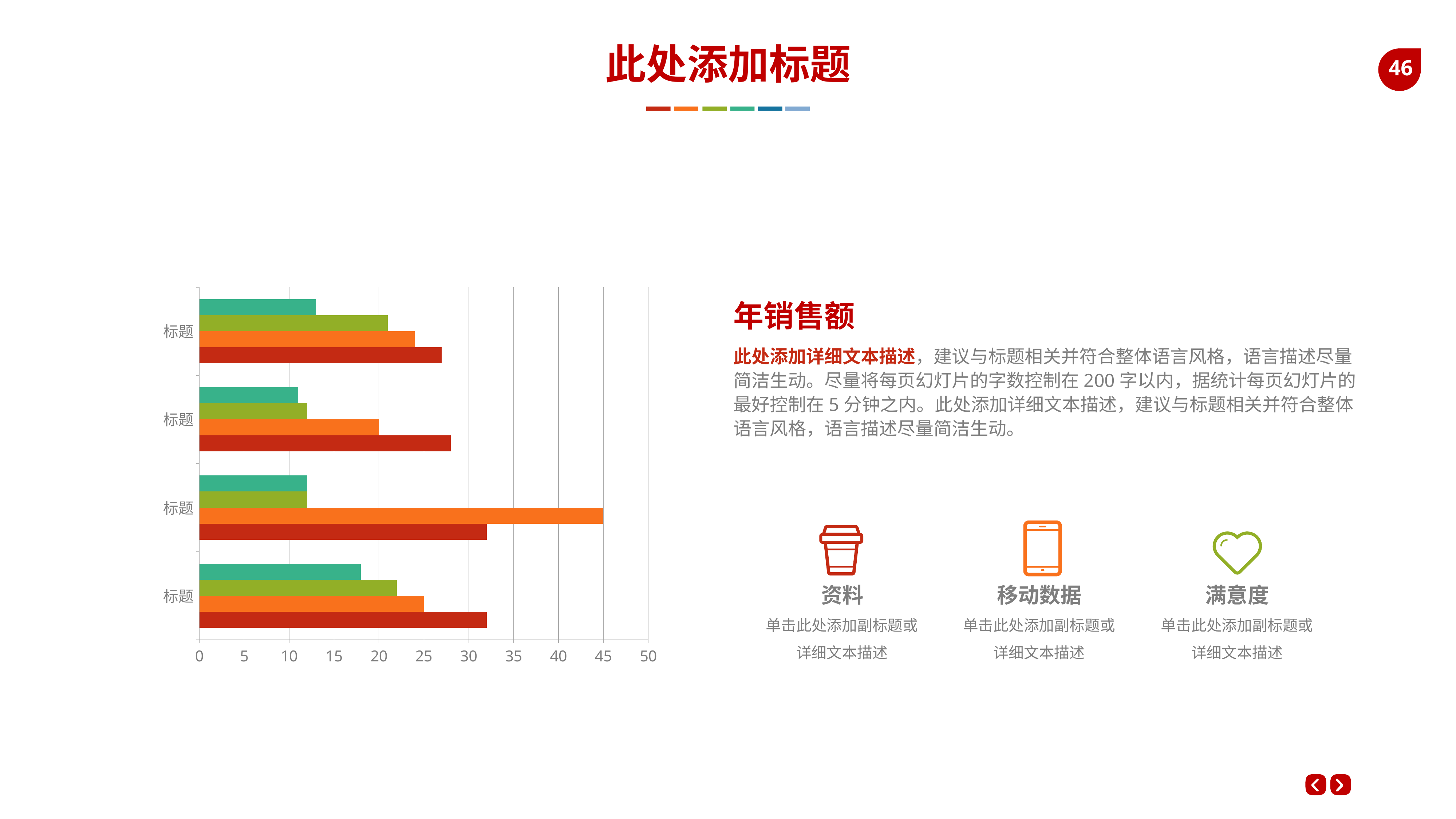
Is the value of the teal bar in the second group from the top greater or less than 15? less What is the interval between tick marks on the horizontal axis of the chart? 5 How many bars are there in each category group of the bar chart? 4 Is the value of the red bar in the top group greater or less than 25? greater What is the maximum value shown on the horizontal axis of the chart? 50 What kind of chart is shown on the slide? bar chart In the third group from the top, which bar is longer, the orange bar or the red bar? the orange bar How many category groups does the bar chart show? 4 Is the value of the orange bar in the second group from the top greater or less than 30? less In the top group, which bar is longer, the red bar or the teal bar? the red bar What is the value of the orange bar in the third group from the top? 45 Which bar is the longest in the whole chart? the orange bar in the third group from the top